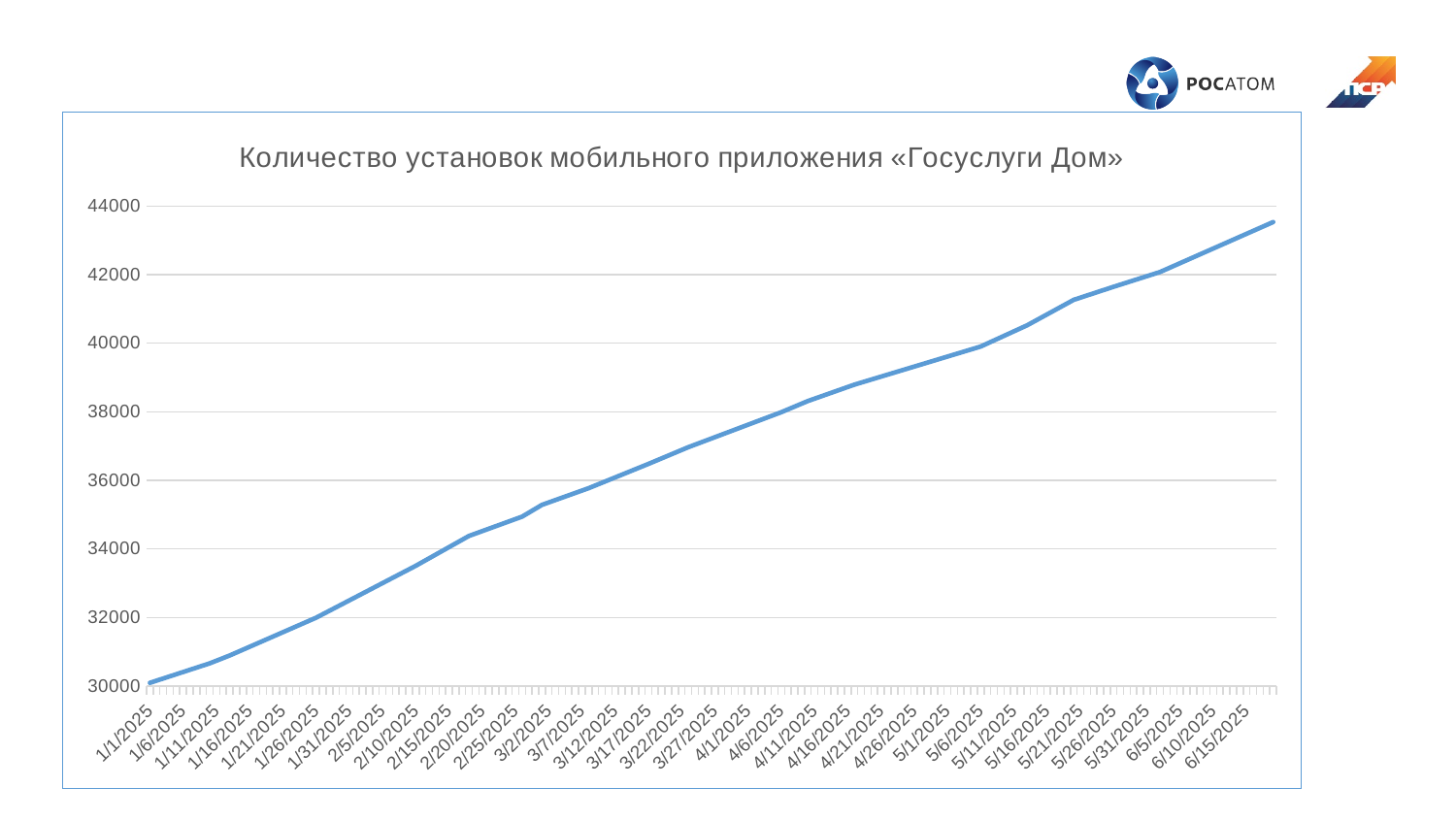
What is the title of the chart? Количество установок мобильного приложения «Госуслуги Дом» Is the value for 5/21/2025 greater or less than 40000? greater Is the value for 6/15/2025 greater or less than 42000? greater Is the value for 5/1/2025 greater or less than 40000? less Do the values rise or fall along the x axis from 1/1/2025 to 6/15/2025? rise What kind of chart is shown on the slide? line chart Which is larger, the value for 5/1/2025 or the value for 3/2/2025? 5/1/2025 Which date has the lowest value on the chart? 1/1/2025